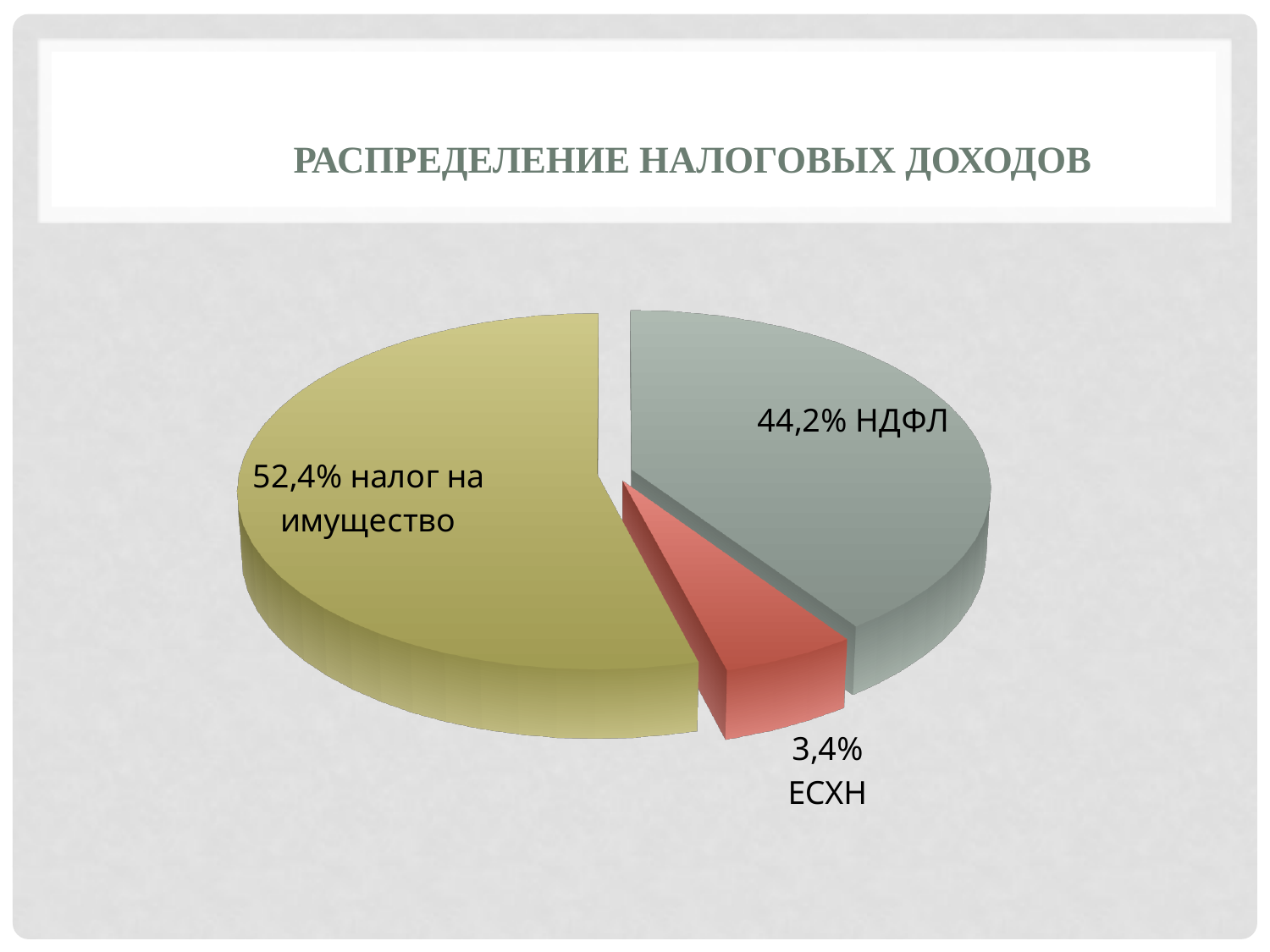
Which category has the smallest share of tax revenues? ЕСХН What colour is the slice for ЕСХН? red Which category has the largest share of tax revenues? налог на имущество Which is larger, the share for НДФЛ or the share for налог на имущество? налог на имущество What kind of chart is shown on the slide? pie chart What is the difference between the share for налог на имущество and the share for НДФЛ? 8,2% What share of tax revenues does НДФЛ account for? 44,2% What share of tax revenues does ЕСХН account for? 3,4% What is the difference between the share for НДФЛ and the share for ЕСХН? 40,8% What is the title of the slide? Распределение налоговых доходов What share of tax revenues does налог на имущество account for? 52,4% How many categories are shown in the pie chart? 3